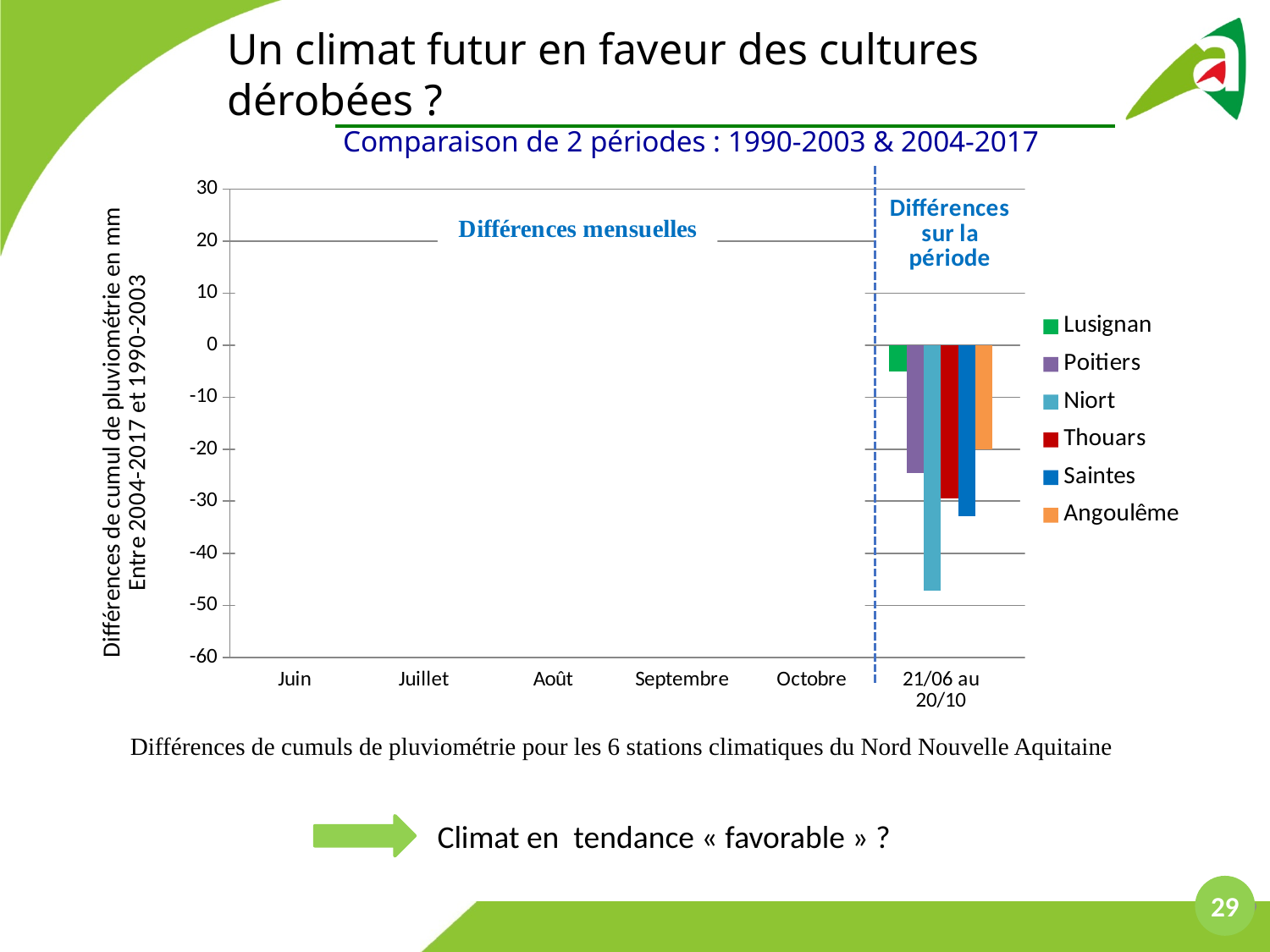
Is the value for Lusignan in the period 21/06 au 20/10 greater or less than -10? greater For the period 21/06 au 20/10, which station has the highest value (closest to zero)? Lusignan Is the value for Poitiers in the period 21/06 au 20/10 greater or less than -20? less How many categories are shown along the x axis? 6 What is the title of the chart? Comparaison de 2 périodes : 1990-2003 & 2004-2017 For the period 21/06 au 20/10, which is larger, the value for Lusignan or the value for Saintes? Lusignan How many series does the legend list? 6 Is the value for Niort in the period 21/06 au 20/10 greater or less than -40? less What kind of chart is shown on the slide? bar chart For the period 21/06 au 20/10, which is larger, the value for Angoulême or the value for Niort? Angoulême For the period 21/06 au 20/10, which station has the lowest (most negative) value? Niort